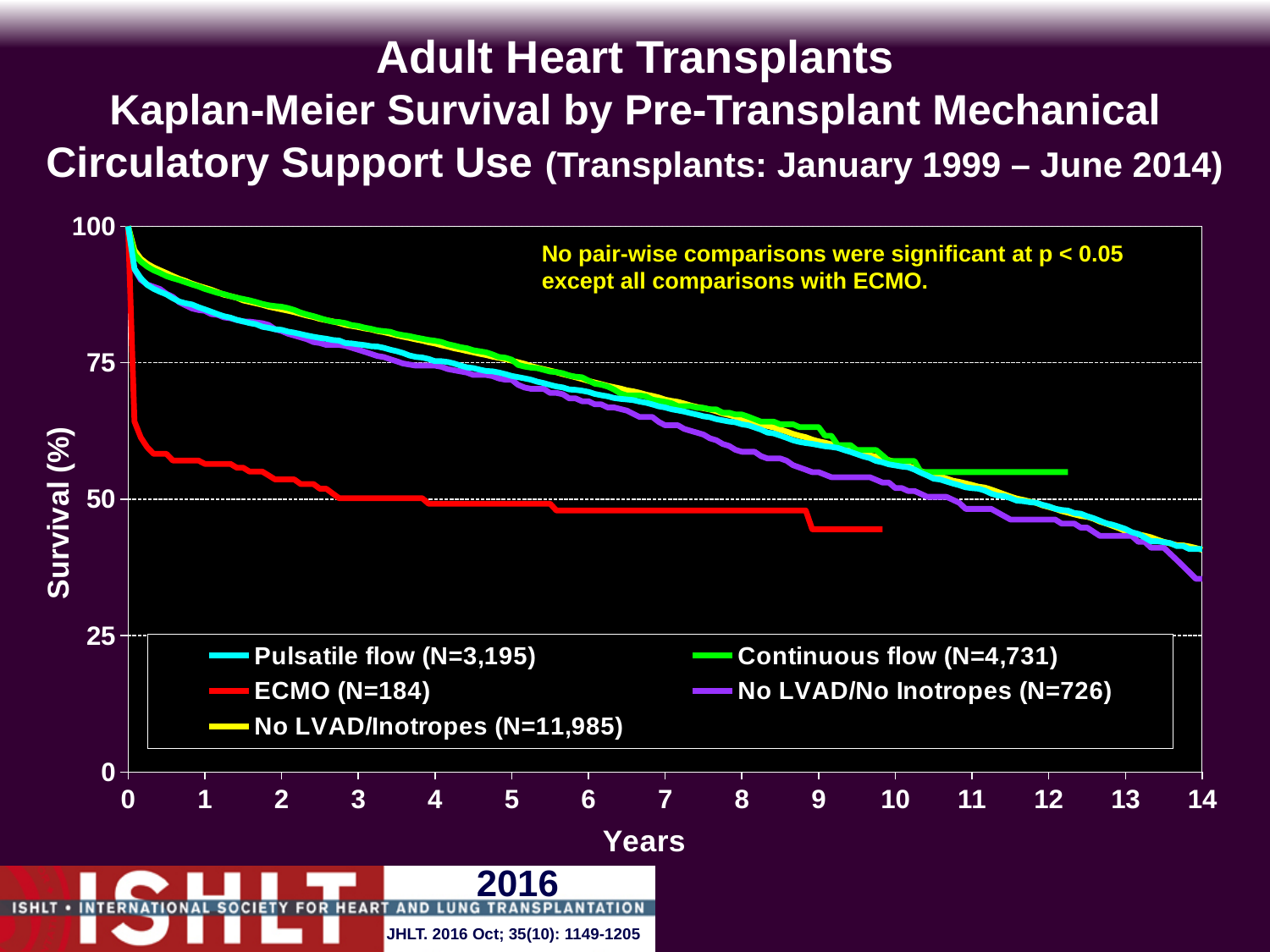
How many series does the legend list? 5 What kind of chart is shown on the slide? line chart Is the survival value for No LVAD/No Inotropes at year 13 greater or less than 50? less According to the legend, what is the N for the ECMO group? N=184 Is the survival value for ECMO at year 9.5 greater or less than 50? less According to the legend, what is the N for the No LVAD/Inotropes group? N=11,985 Is the survival value for ECMO at year 1 greater or less than 50? greater At year 5, which has higher survival: ECMO or Continuous flow? Continuous flow Do the survival curves rise or fall as years increase? fall Which series has the lowest survival across the years shown? ECMO